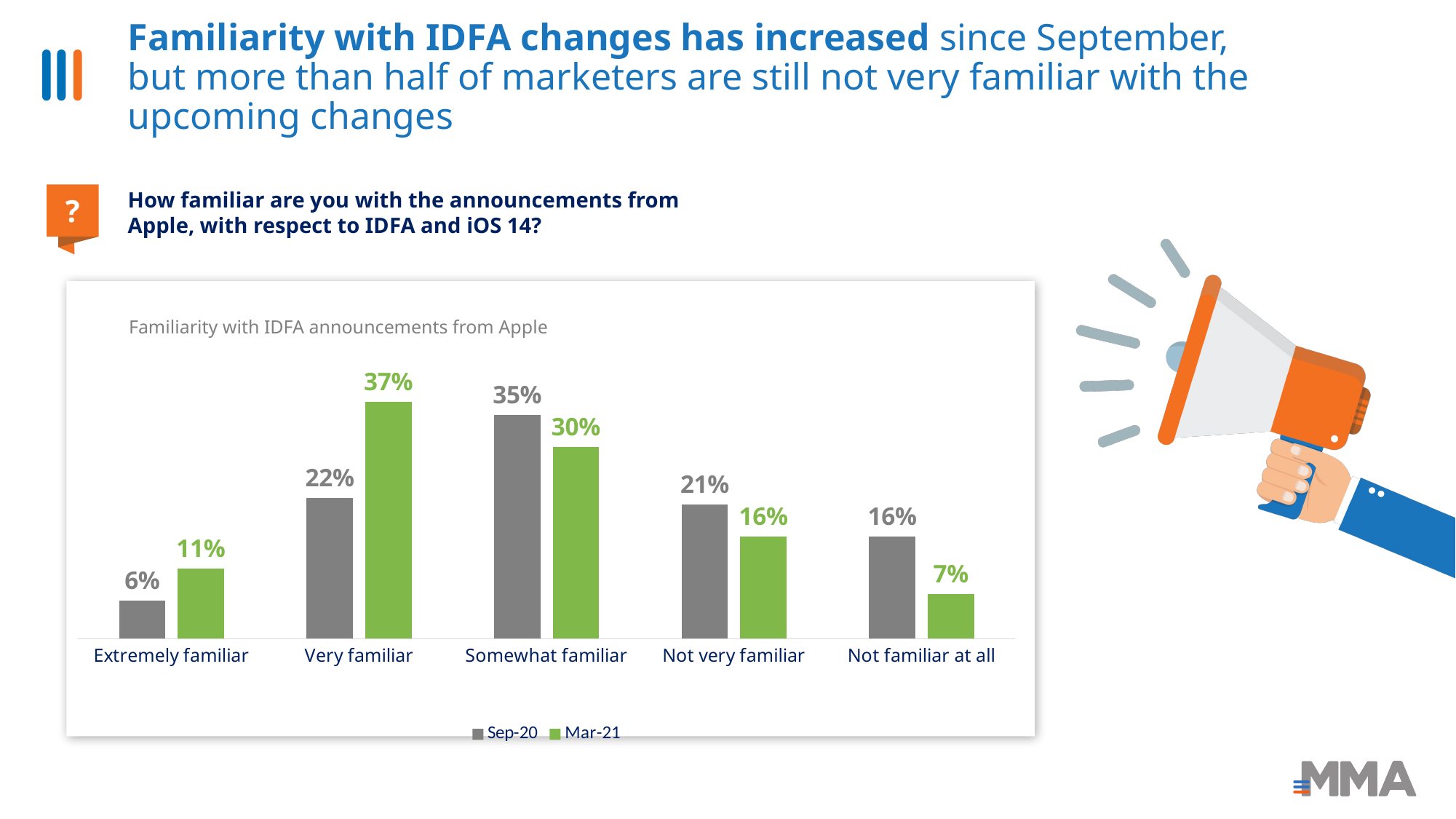
What is the Mar-21 value for Not familiar at all? 7% Which category has the highest Sep-20 value? Somewhat familiar What is the Sep-20 value for Extremely familiar? 6% What is the Sep-20 value for Somewhat familiar? 35% How many series does the legend list? 2 What is the Mar-21 value for Very familiar? 37% Which category has the lowest Mar-21 value? Not familiar at all Which is larger for Somewhat familiar: the Sep-20 value or the Mar-21 value? Sep-20 What kind of chart is shown? Bar chart What is the difference between the Sep-20 and Mar-21 values for Not familiar at all? 9% How many categories are shown on the x axis? 5 What is the difference between the Mar-21 and Sep-20 values for Very familiar? 15%